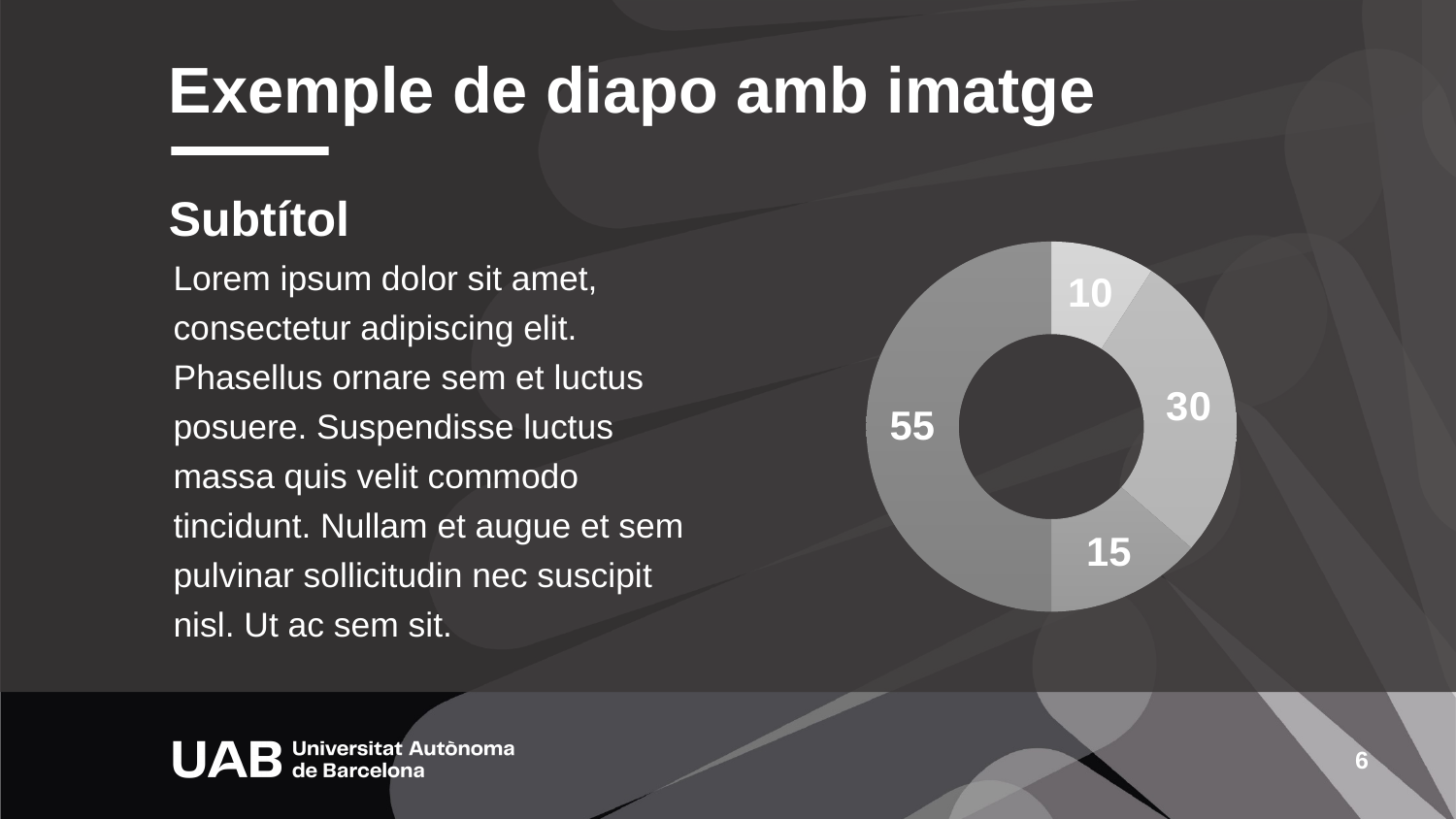
What share of the doughnut chart does the slice labelled 55 represent? 50% What is the value of the largest slice in the doughnut chart? 55 What is the difference between the largest slice (55) and the slice labelled 30? 25 Which is larger, the slice labelled 30 or the slice labelled 15? 30 What is the difference between the slice labelled 30 and the slice labelled 15? 15 What value is labelled on the large slice on the left side of the doughnut chart? 55 What is the total of all the slice values in the doughnut chart? 110 What value is labelled on the slice at the bottom of the doughnut chart? 15 What kind of chart is shown on the slide? Doughnut chart How many slices does the doughnut chart have? 4 What value is labelled on the slice on the right side of the doughnut chart? 30 What is the value of the smallest slice in the doughnut chart? 10